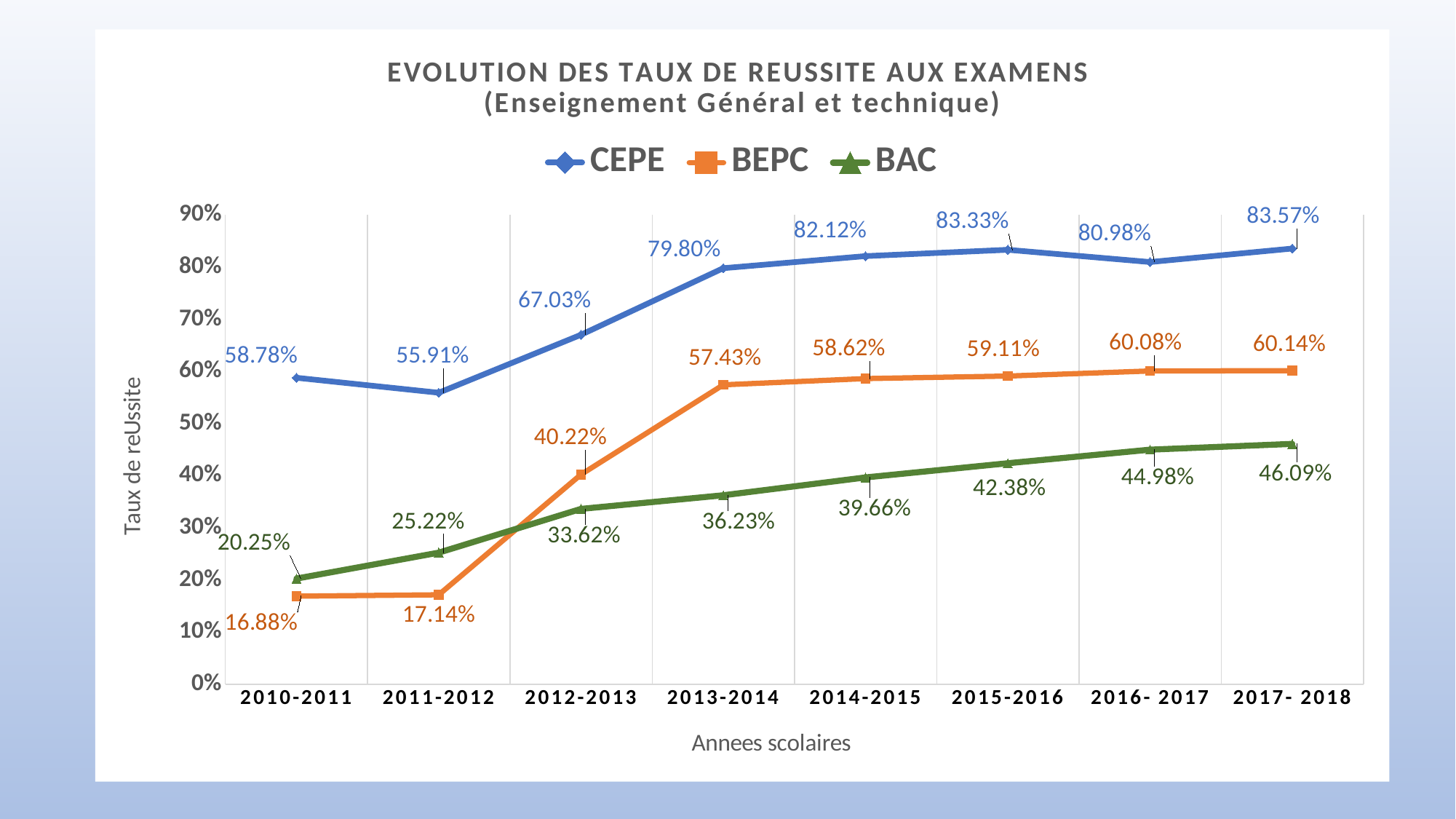
In which school year is the CEPE pass rate highest? 2017- 2018 What is the BAC pass rate for 2015-2016? 42.38% How many series does the legend list? 3 What is the CEPE pass rate for 2013-2014? 79.80% What is the BEPC pass rate for 2011-2012? 17.14% What is the difference between the BAC pass rate in 2017- 2018 and in 2010-2011? 25.84% What kind of chart is shown on the slide? line chart Which is larger in 2010-2011, the BEPC pass rate or the BAC pass rate? BAC How many school years are shown on the x axis? 8 In which school year is the BEPC pass rate lowest? 2010-2011 Is the BEPC pass rate for 2012-2013 greater or less than 50%? less Does the BAC pass rate rise or fall from 2010-2011 to 2017- 2018? rise